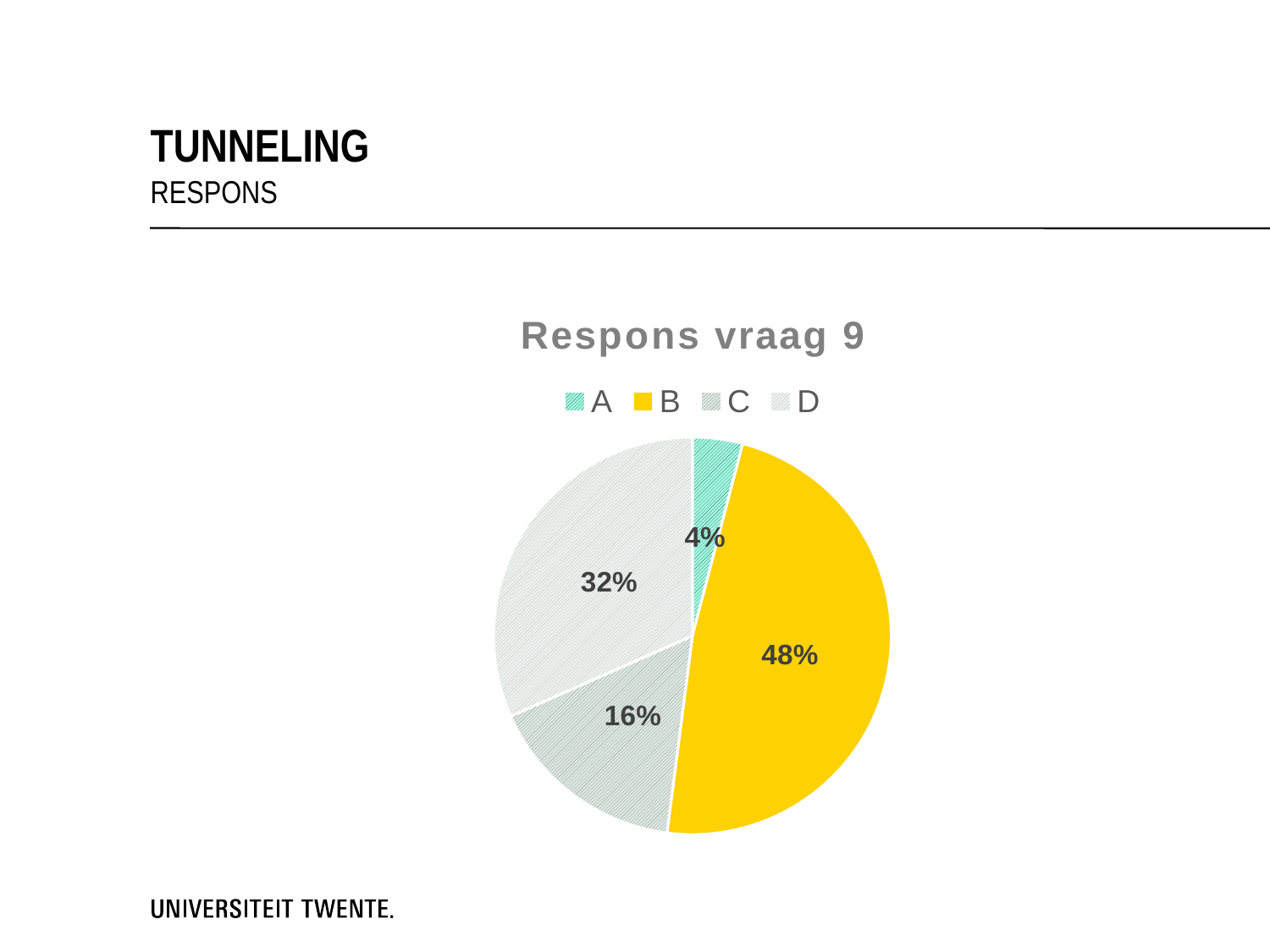
Which is larger, the share for C or the share for D? D What percentage of the pie does slice B represent? 48% What colour is the slice for category B? yellow What percentage of the pie does slice C represent? 16% How many categories does the legend list? 4 What kind of chart is shown on the slide? pie chart Which category has the smallest share of the pie? A What percentage of the pie does slice A represent? 4% Which category has the largest share of the pie? B What percentage of the pie does slice D represent? 32% What is the title of the chart? Respons vraag 9 What is the difference in percentage points between slice B and slice D? 16